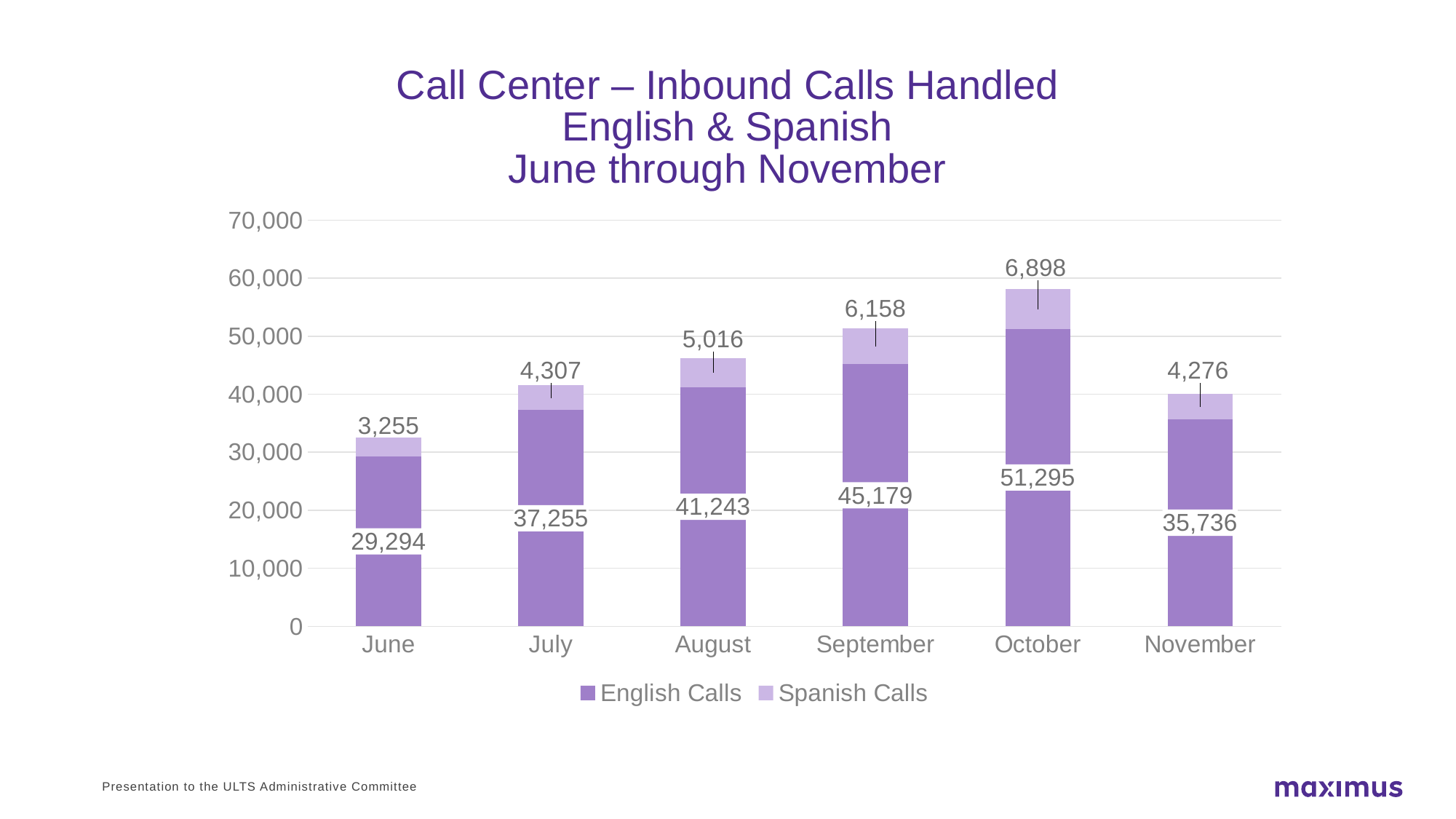
What is the total number of calls (English plus Spanish) handled in October? 58,193 How many English Calls were handled in October? 51,295 What is the difference between English Calls in October and English Calls in November? 15,559 How many months are shown on the x axis? 6 Which is larger: Spanish Calls in September or Spanish Calls in July? Spanish Calls in September What kind of chart is shown on the slide? Stacked bar chart What is the total number of calls (English plus Spanish) handled in June? 32,549 Which month has the lowest number of Spanish Calls? June How many series does the legend list? 2 Which month has the highest number of English Calls? October How many Spanish Calls were handled in June? 3,255 Do English Calls rise or fall from June through October? Rise